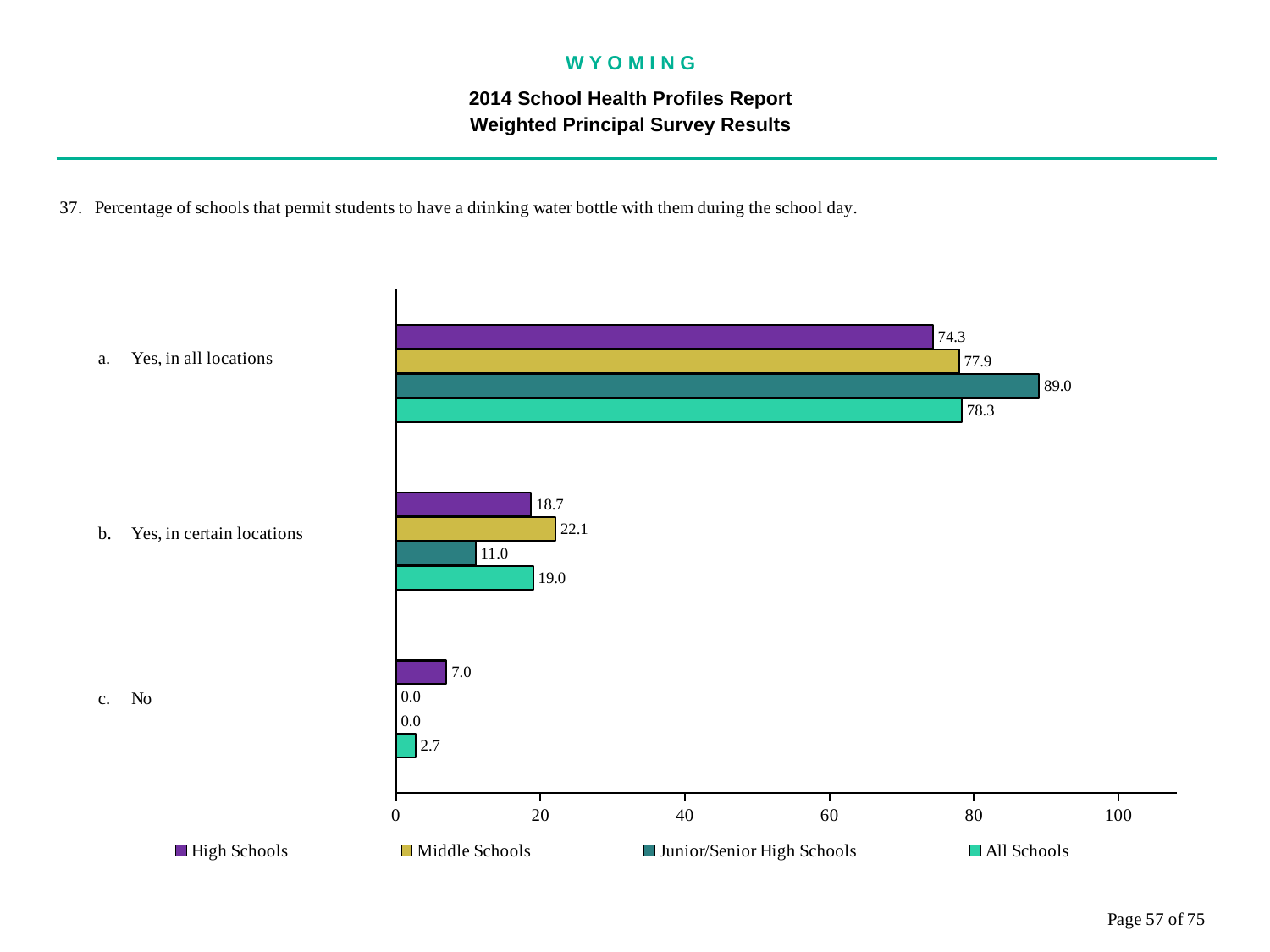
Which series has the highest value for "Yes, in all locations"? Junior/Senior High Schools What is the value for Junior/Senior High Schools for "Yes, in all locations"? 89.0 How many series does the legend list? 4 Which series has the lowest value for "Yes, in certain locations"? Junior/Senior High Schools What is the difference between the Middle Schools and High Schools values for "Yes, in all locations"? 3.6 What is the value for High Schools for "No"? 7.0 How many response categories are shown on the chart? 3 Which is larger for "Yes, in certain locations": the High Schools value or the All Schools value? All Schools What is the value for All Schools for "Yes, in all locations"? 78.3 What is the value for Middle Schools for "Yes, in certain locations"? 22.1 What kind of chart is shown on the slide? Bar chart Is the value for Junior/Senior High Schools for "Yes, in all locations" greater or less than 80? greater